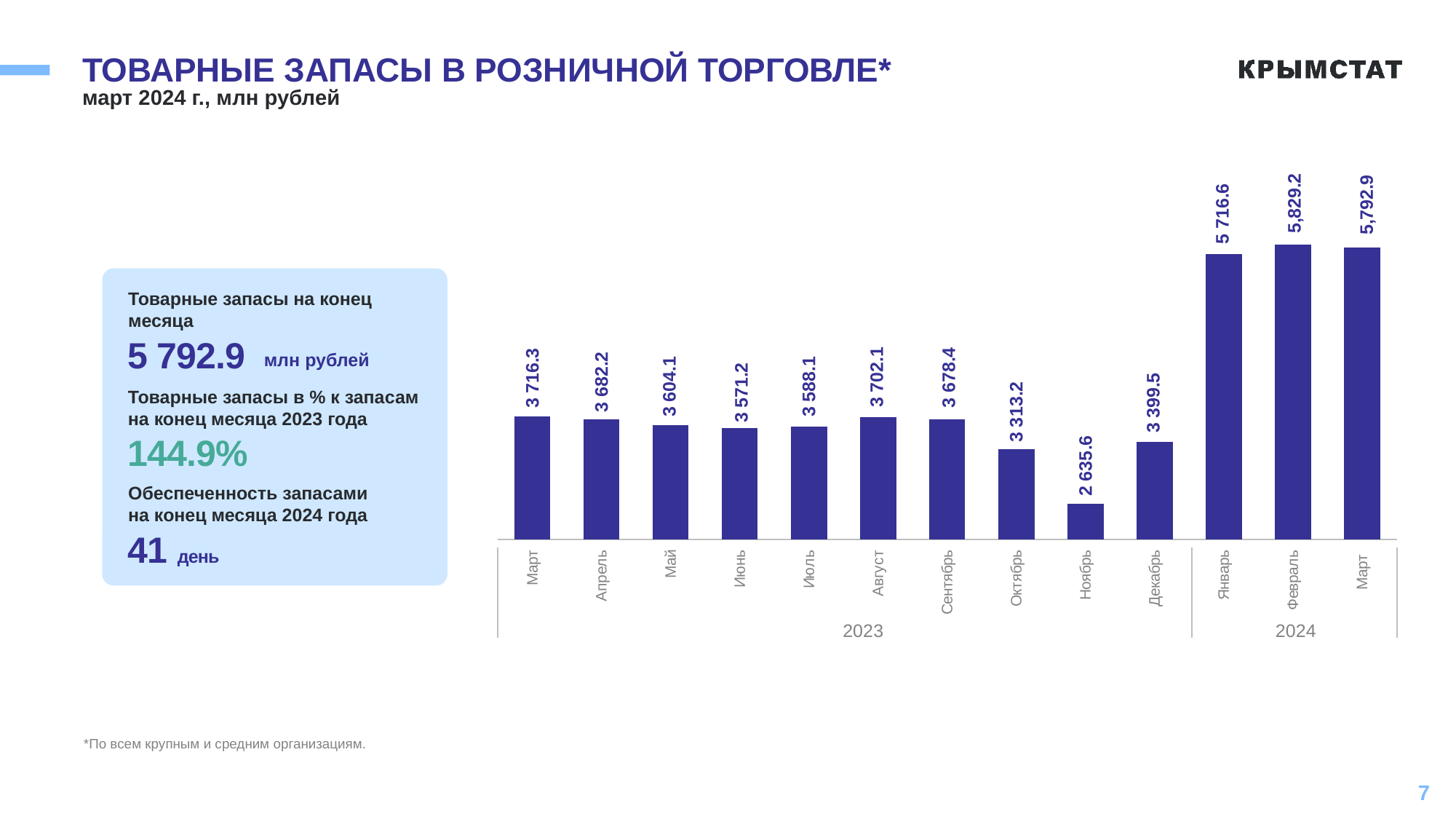
What is the value for Ноябрь 2023? 2 635.6 What is the value for Февраль 2024? 5,829.2 What kind of chart is shown on the slide? Bar chart How many months (bars) are shown in the chart? 13 Which is larger, the value for Октябрь 2023 or Декабрь 2023? Декабрь 2023 What is the difference between the values for Март 2024 and Март 2023? 2 076.6 Do the values rise or fall from Декабрь 2023 to Январь 2024? Rise What is the value for Август 2023? 3 702.1 Which month has the highest value? Февраль 2024 Which month has the lowest value? Ноябрь 2023 What is the value for Март 2023? 3 716.3 What is the difference between the values for Декабрь 2023 and Ноябрь 2023? 763.9